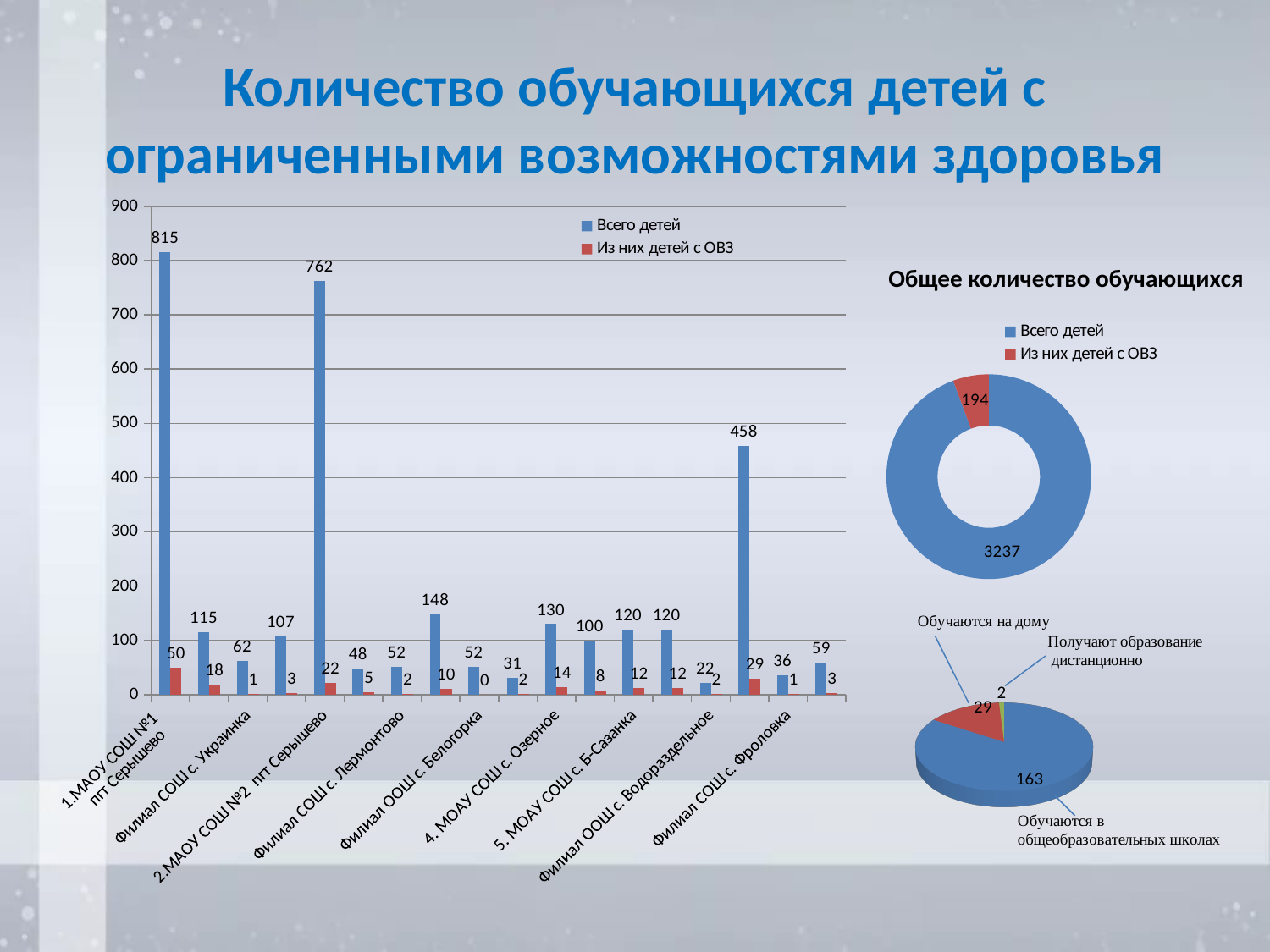
In the donut chart 'Общее количество обучающихся', what is the difference between 'Всего детей' and 'Из них детей с ОВЗ'? 3043 In the donut chart 'Общее количество обучающихся', what is the value for 'Из них детей с ОВЗ'? 194 How many series does the legend of the bar chart list? 2 In the pie chart at the bottom right, what is the value for 'Обучаются в общеобразовательных школах'? 163 In the pie chart at the bottom right, which slice is the smallest? Получают образование дистанционно In the bar chart, which category has the highest 'Всего детей' value? 1.МАОУ СОШ №1 пгт Серышево In the pie chart at the bottom right, what is the total of all slices? 194 In the donut chart 'Общее количество обучающихся', what is the value for 'Всего детей'? 3237 In the bar chart, what is the 'Из них детей с ОВЗ' value for 1.МАОУ СОШ №1 ппт Серышево? 50 In the bar chart, what is the highest value in the 'Всего детей' series? 815 In the bar chart, how many categories have a 'Всего детей' value above 400? 3 What kind of chart is the large chart on the left of the slide? bar chart